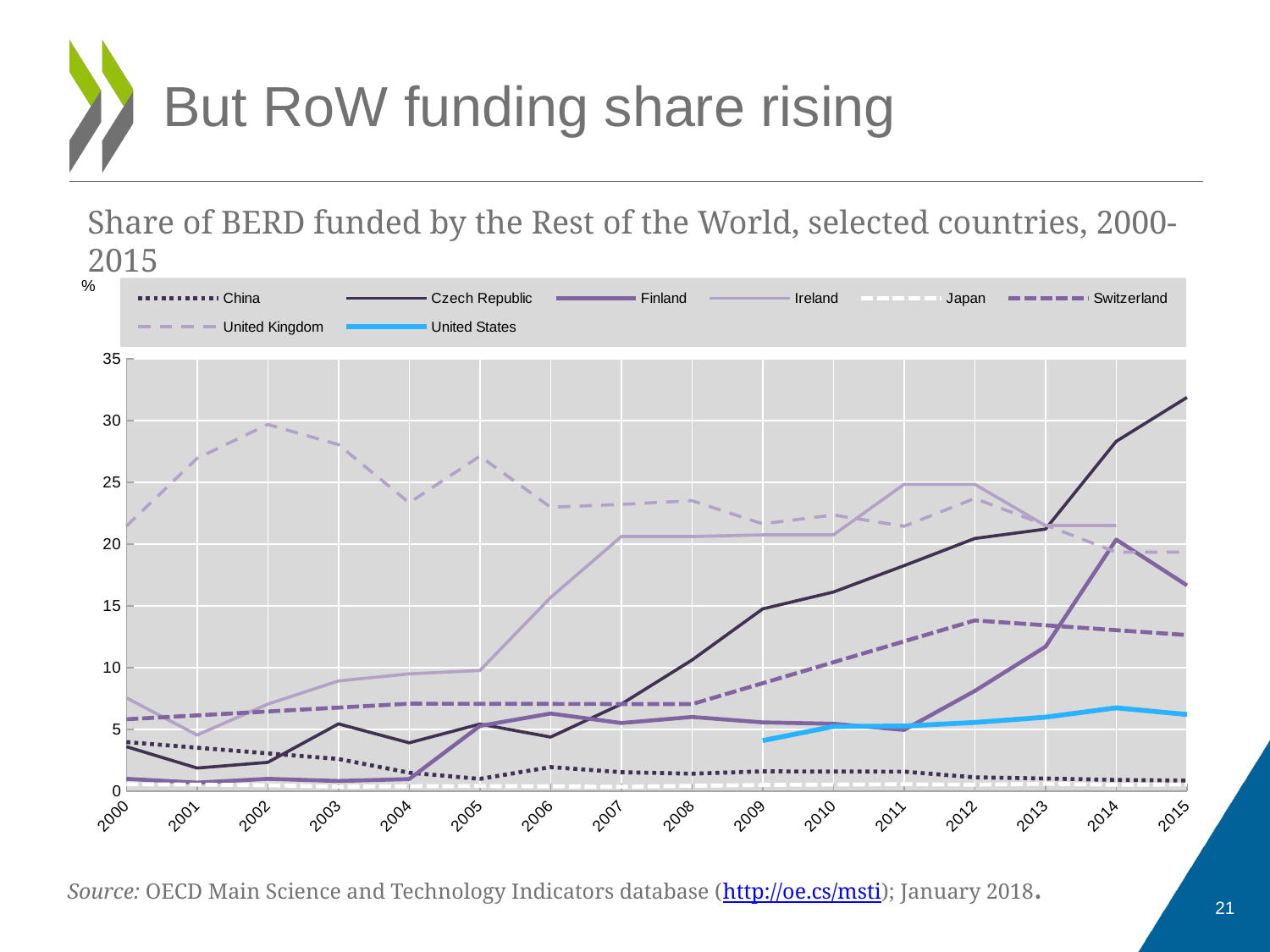
What kind of chart is shown on the slide? Line chart Which country has the highest value in 2000? United Kingdom In 2015, which is larger: the value for Finland or the value for Switzerland? Finland Which country has the highest value in 2015? Czech Republic Is the value for Switzerland in 2012 greater or less than 10? greater How many years are shown along the x axis? 16 Is the value for the Czech Republic in 2015 greater or less than 30? greater Is the value for Finland in 2004 greater or less than 5? less In which year does the United States series begin? 2009 How many series does the legend list? 8 Does the Czech Republic series rise or fall between 2000 and 2015? rise